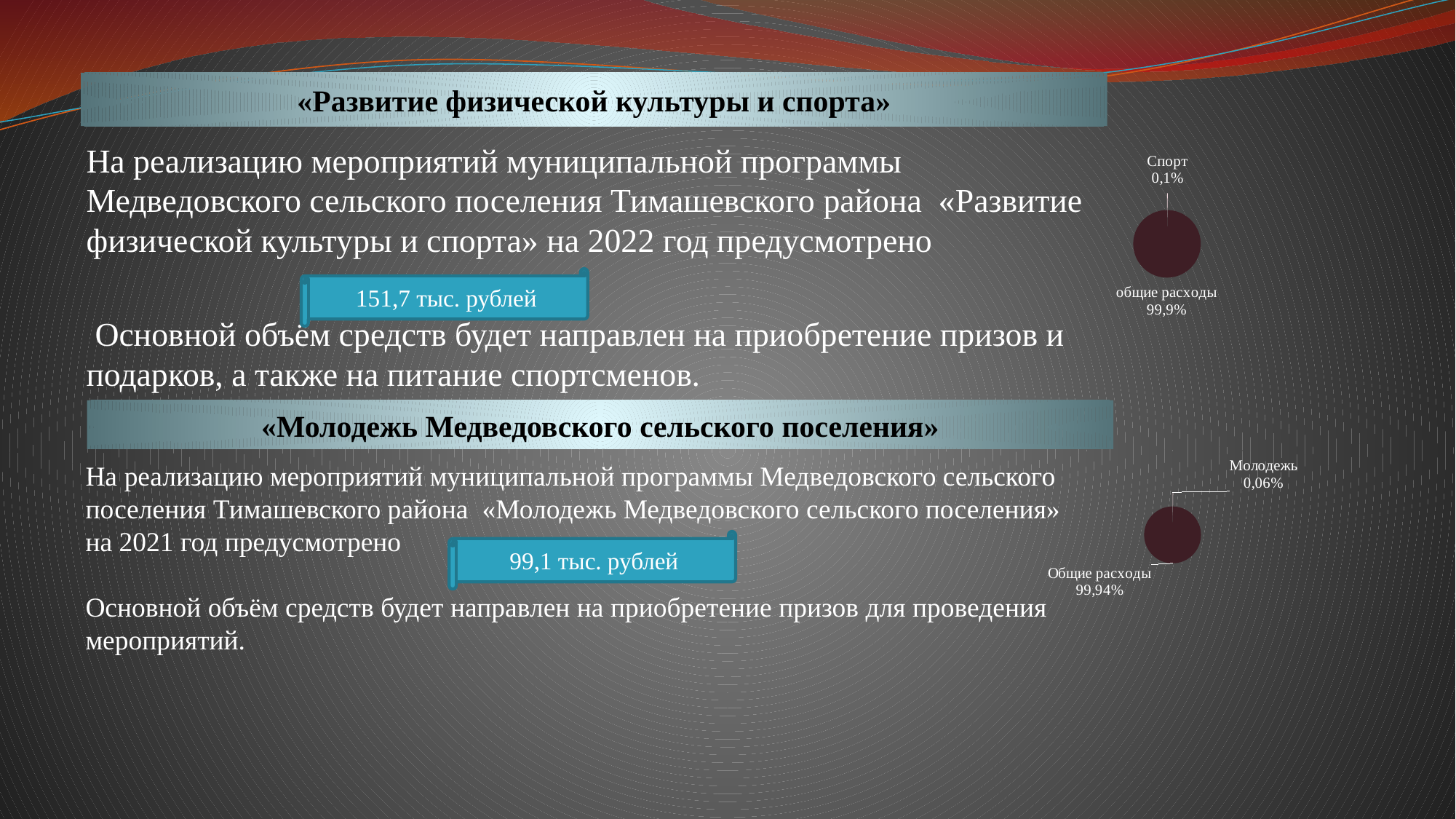
In the lower-right pie chart, is the share for Общие расходы larger or smaller than the share for Молодежь? larger In the lower-right pie chart, which slice is the largest? Общие расходы In the upper-right pie chart, which slice is the largest? общие расходы What kind of chart is the upper-right chart on the slide? pie chart In the lower-right pie chart, what share is labelled for Молодежь? 0,06% In the lower-right pie chart, what share is labelled for Общие расходы? 99,94% How many slices are labelled in the lower-right pie chart? 2 In the upper-right pie chart, what share is labelled for общие расходы? 99,9% In the upper-right pie chart, which slice is the smallest? Спорт In the upper-right pie chart, what share is labelled for Спорт? 0,1% What kind of chart is the lower-right chart on the slide? pie chart How many slices are labelled in the upper-right pie chart? 2